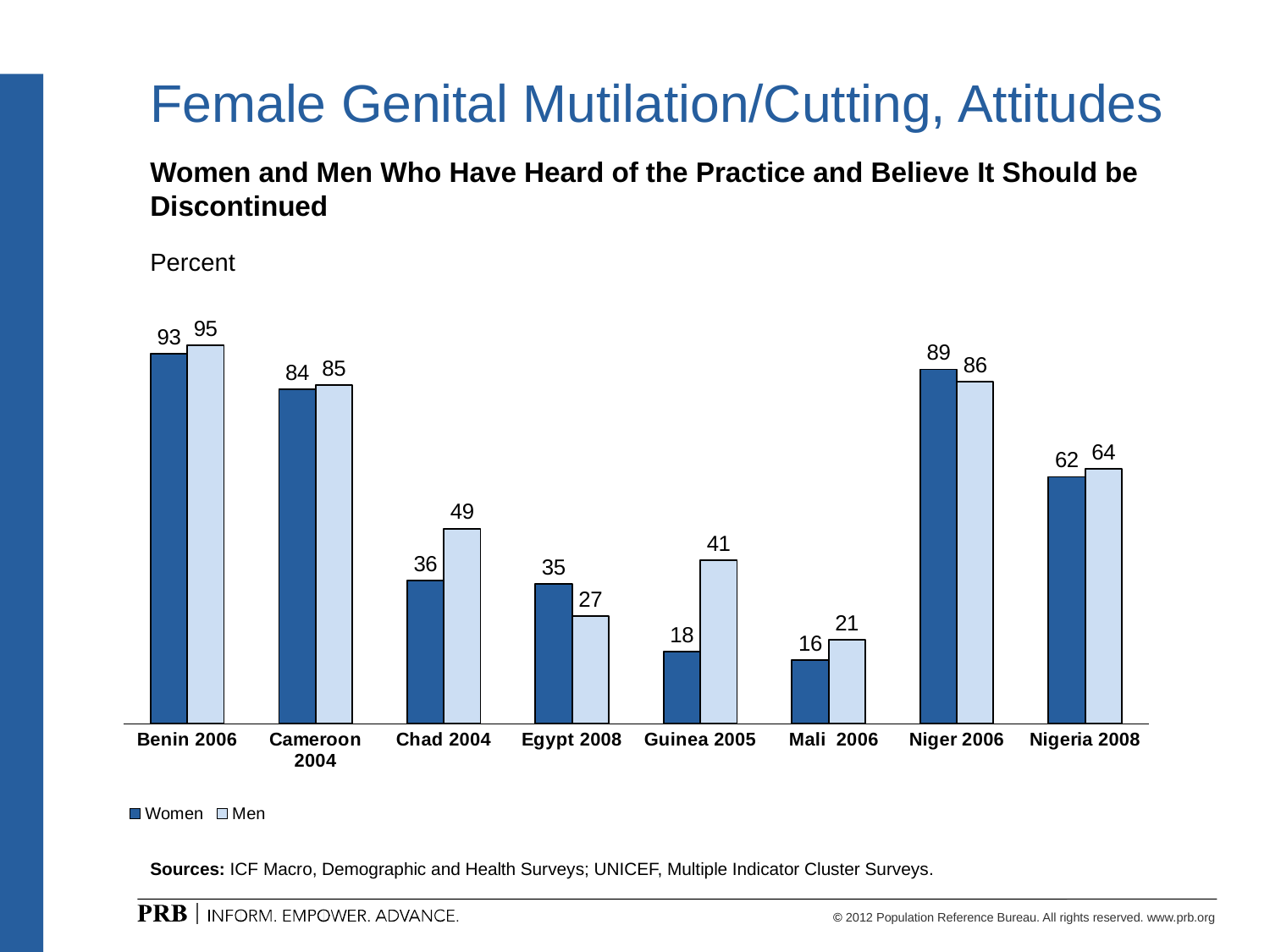
What is the value for Women in Chad 2004? 36 What is the difference between the Men and Women values for Guinea 2005? 23 How many countries are shown on the x axis? 8 What kind of chart is shown on the slide? Bar chart How many series does the legend list? 2 Which country has the highest value for Women? Benin 2006 What is the value for Men in Guinea 2005? 41 What is the difference between the Women values for Benin 2006 and Nigeria 2008? 31 Which is larger in Egypt 2008, the value for Women or the value for Men? Women What is the value for Women in Niger 2006? 89 Which country has the lowest value for Men? Mali 2006 Which series is shown in dark blue according to the legend? Women